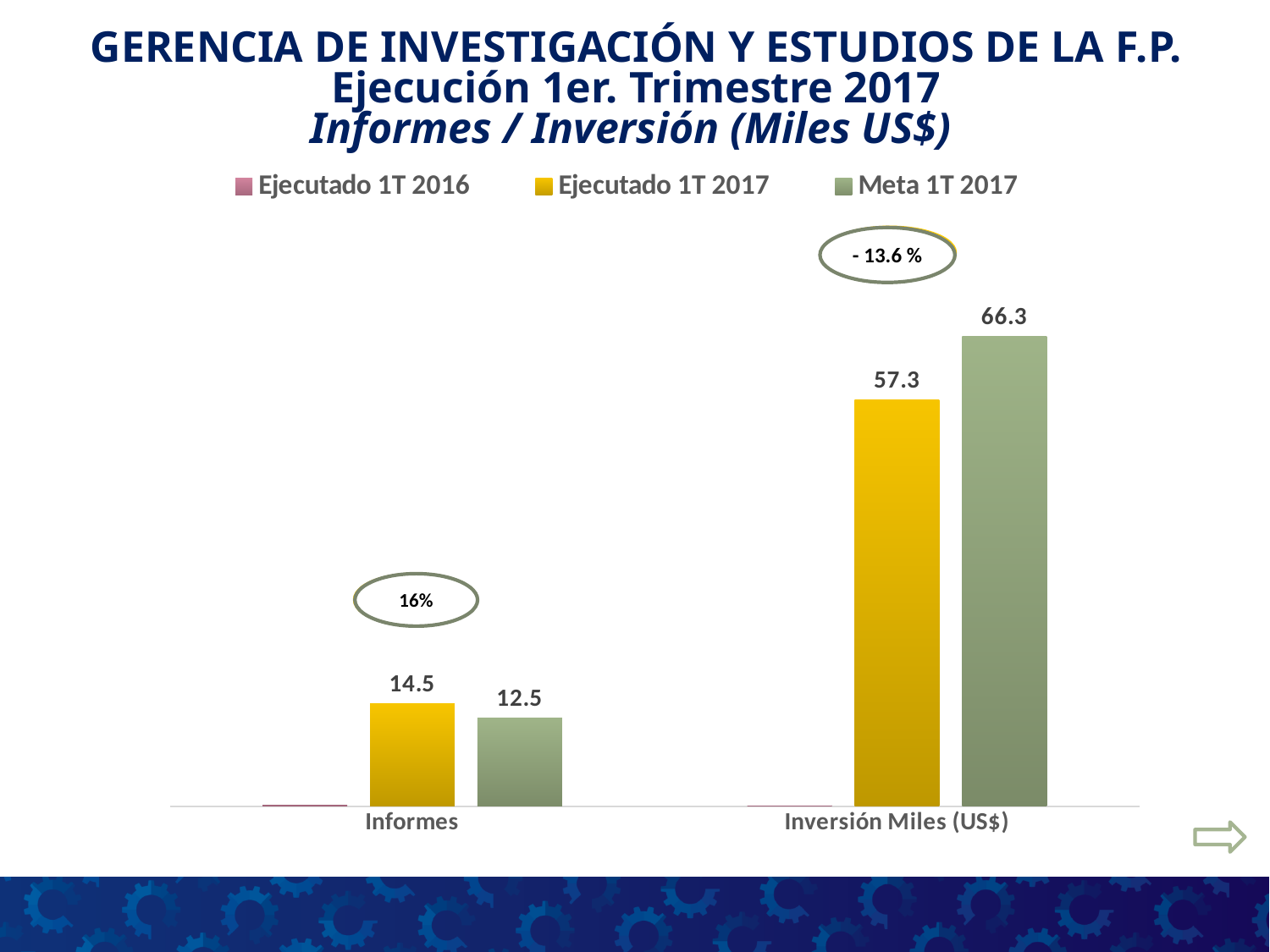
What is the Ejecutado 1T 2017 value for Informes? 14.5 For Informes, which is larger: Ejecutado 1T 2017 or Meta 1T 2017? Ejecutado 1T 2017 How many series does the legend list? 3 What is the Ejecutado 1T 2017 value for Inversión Miles (US$)? 57.3 For Inversión Miles (US$), which is larger: Ejecutado 1T 2017 or Meta 1T 2017? Meta 1T 2017 What is the Meta 1T 2017 value for Inversión Miles (US$)? 66.3 How many categories are shown on the x axis? 2 What kind of chart is shown on the slide? Bar chart What is the difference between Ejecutado 1T 2017 and Meta 1T 2017 for Informes? 2.0 Which bar has the highest value on the chart? Meta 1T 2017 for Inversión Miles (US$) What is the Meta 1T 2017 value for Informes? 12.5 What is the difference between Meta 1T 2017 and Ejecutado 1T 2017 for Inversión Miles (US$)? 9.0